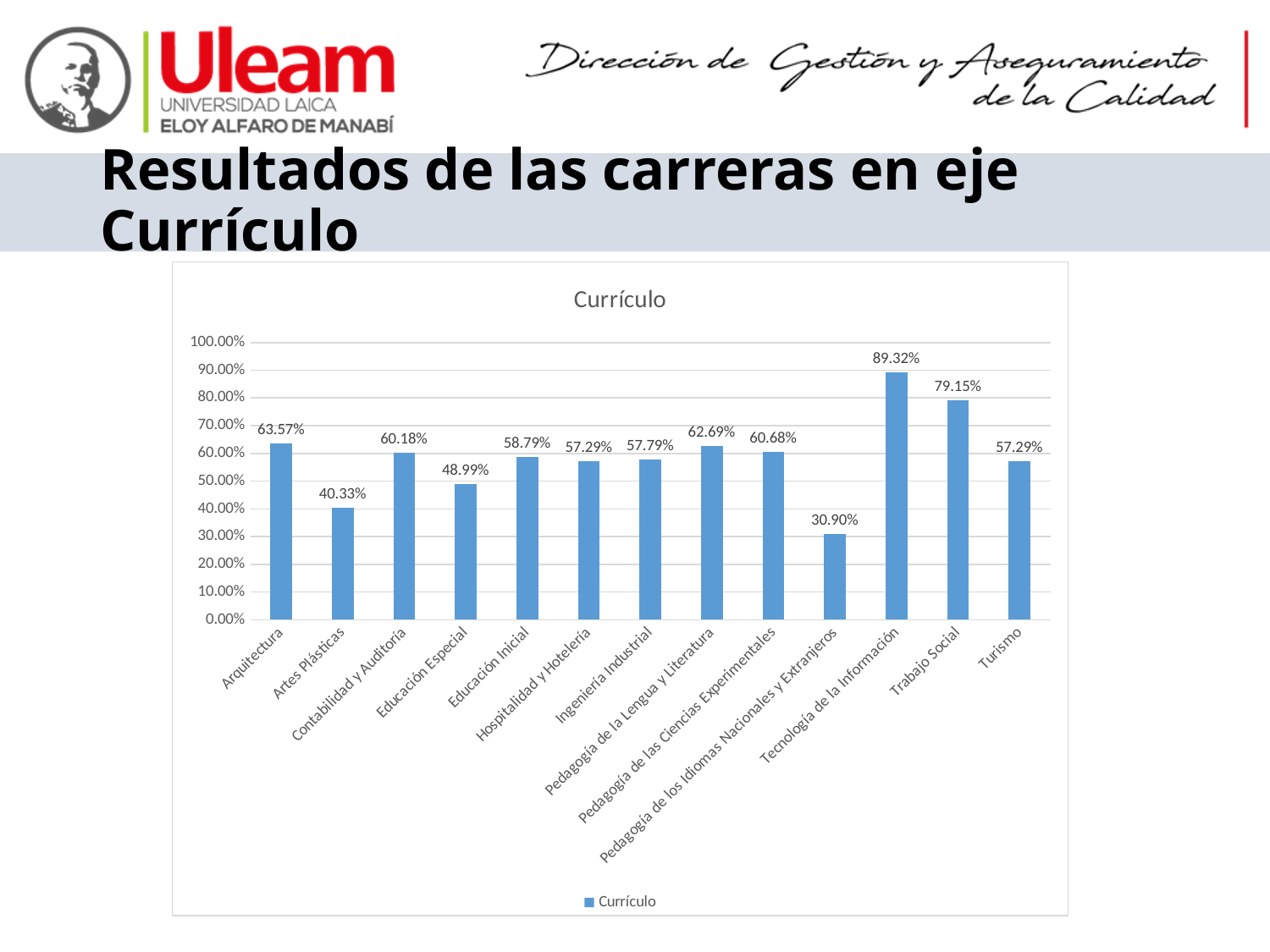
What is the value for Pedagogía de los Idiomas Nacionales y Extranjeros? 30.90% What is the difference between the values for Tecnología de la Información and Trabajo Social? 10.17% What is the value for Tecnología de la Información? 89.32% What is the value for Educación Especial? 48.99% What is the value for Arquitectura? 63.57% What kind of chart is shown? bar chart Which is larger, the value for Artes Plásticas or the value for Educación Especial? Educación Especial Which category has the highest value? Tecnología de la Información Is the value for Trabajo Social greater or less than 70.00%? greater Which category has the lowest value? Pedagogía de los Idiomas Nacionales y Extranjeros What is the title of the chart? Currículo How many categories are shown on the x axis? 13